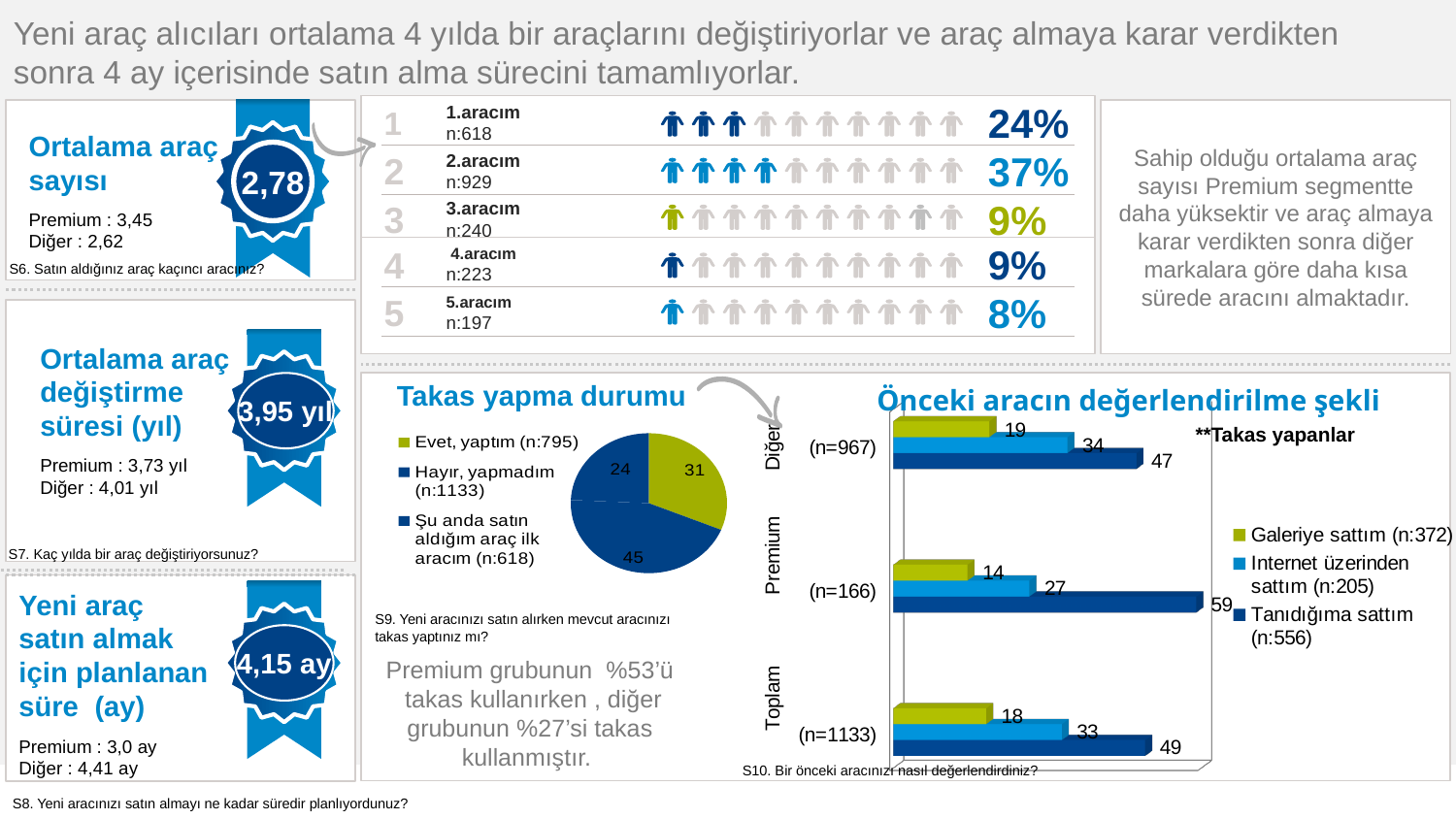
In the 'Takas yapma durumu' pie chart, which slice is the smallest? Şu anda satın aldığım araç ilk aracım (n:618) In the 'Takas yapma durumu' pie chart, which slice is the largest? Hayır, yapmadım (n:1133) In the 'Önceki aracın değerlendirilme şekli' chart, which is larger for Premium: 'Galeriye sattım' or 'Internet üzerinden sattım'? Internet üzerinden sattım In the 'Takas yapma durumu' pie chart, what value is shown for 'Evet, yaptım (n:795)'? 31 In the 'Önceki aracın değerlendirilme şekli' chart, what is the difference between 'Tanıdığıma sattım' for Premium and for Diğer? 12 In the 'Önceki aracın değerlendirilme şekli' chart, what is the value of 'Internet üzerinden sattım' for Toplam? 33 What type of chart is 'Önceki aracın değerlendirilme şekli'? Bar chart How many series does the legend of the 'Önceki aracın değerlendirilme şekli' chart list? 3 In the 'Önceki aracın değerlendirilme şekli' chart, what is the value of 'Galeriye sattım' for Diğer? 19 How many slices does the 'Takas yapma durumu' pie chart have? 3 What type of chart is 'Takas yapma durumu'? Pie chart In the 'Önceki aracın değerlendirilme şekli' chart, what is the value of 'Tanıdığıma sattım' for Premium? 59